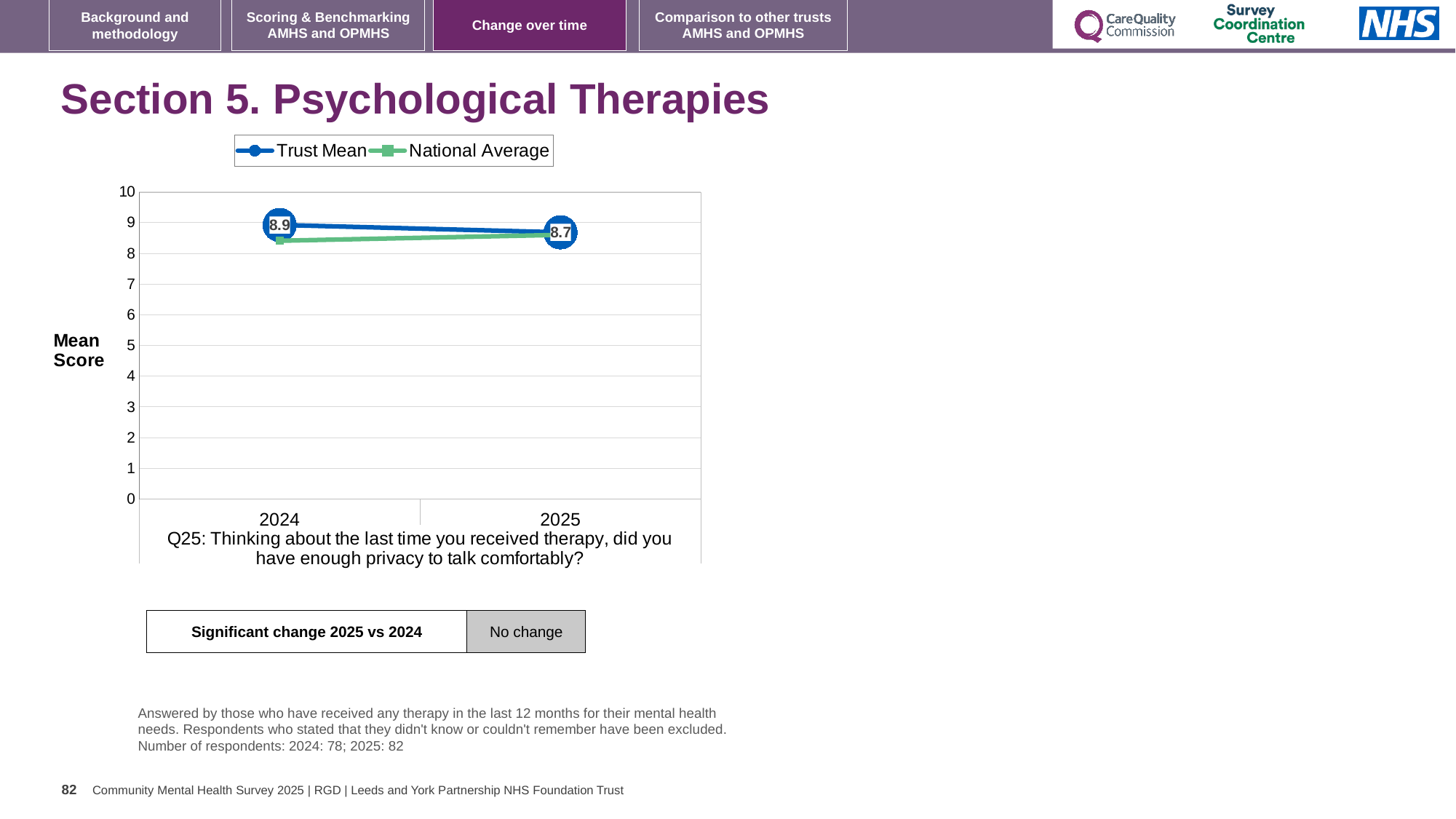
What is the Trust Mean value for 2024? 8.9 How many years are plotted on the x axis? 2 By how much did the Trust Mean change from 2024 to 2025? 0.2 What kind of chart is shown on the slide? line chart What is the Trust Mean value for 2025? 8.7 What is the label on the y axis of the chart? Mean Score How many series does the legend list? 2 Does the National Average rise or fall from 2024 to 2025? rise In 2024, which is larger: the Trust Mean or the National Average? Trust Mean Does the Trust Mean rise or fall from 2024 to 2025? fall In which year is the Trust Mean highest? 2024 Is the National Average value for 2024 greater or less than 9? less